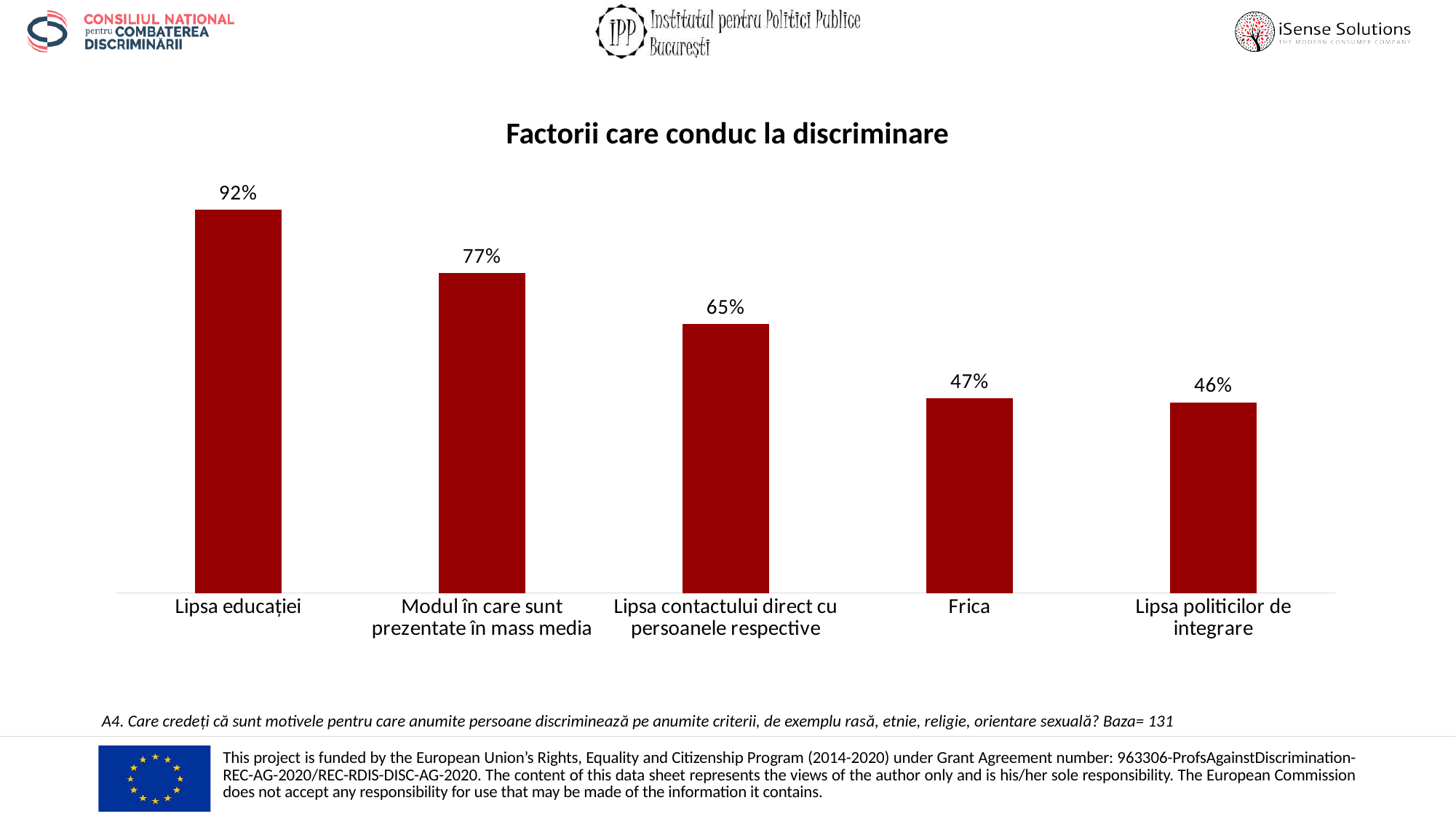
Which category has the lowest value? Lipsa politicilor de integrare What is the title of the chart? Factorii care conduc la discriminare What kind of chart is shown on the slide? Bar chart What is the value for Lipsa educației? 92% Which category has the highest value? Lipsa educației What is the value for Lipsa politicilor de integrare? 46% How many categories are shown in the chart? 5 What is the value for Frica? 47% Which is larger, the value for Modul în care sunt prezentate în mass media or the value for Lipsa contactului direct cu persoanele respective? Modul în care sunt prezentate în mass media What is the value for Modul în care sunt prezentate în mass media? 77% What is the value for Lipsa contactului direct cu persoanele respective? 65% What is the difference between the values for Lipsa educației and Frica? 45%